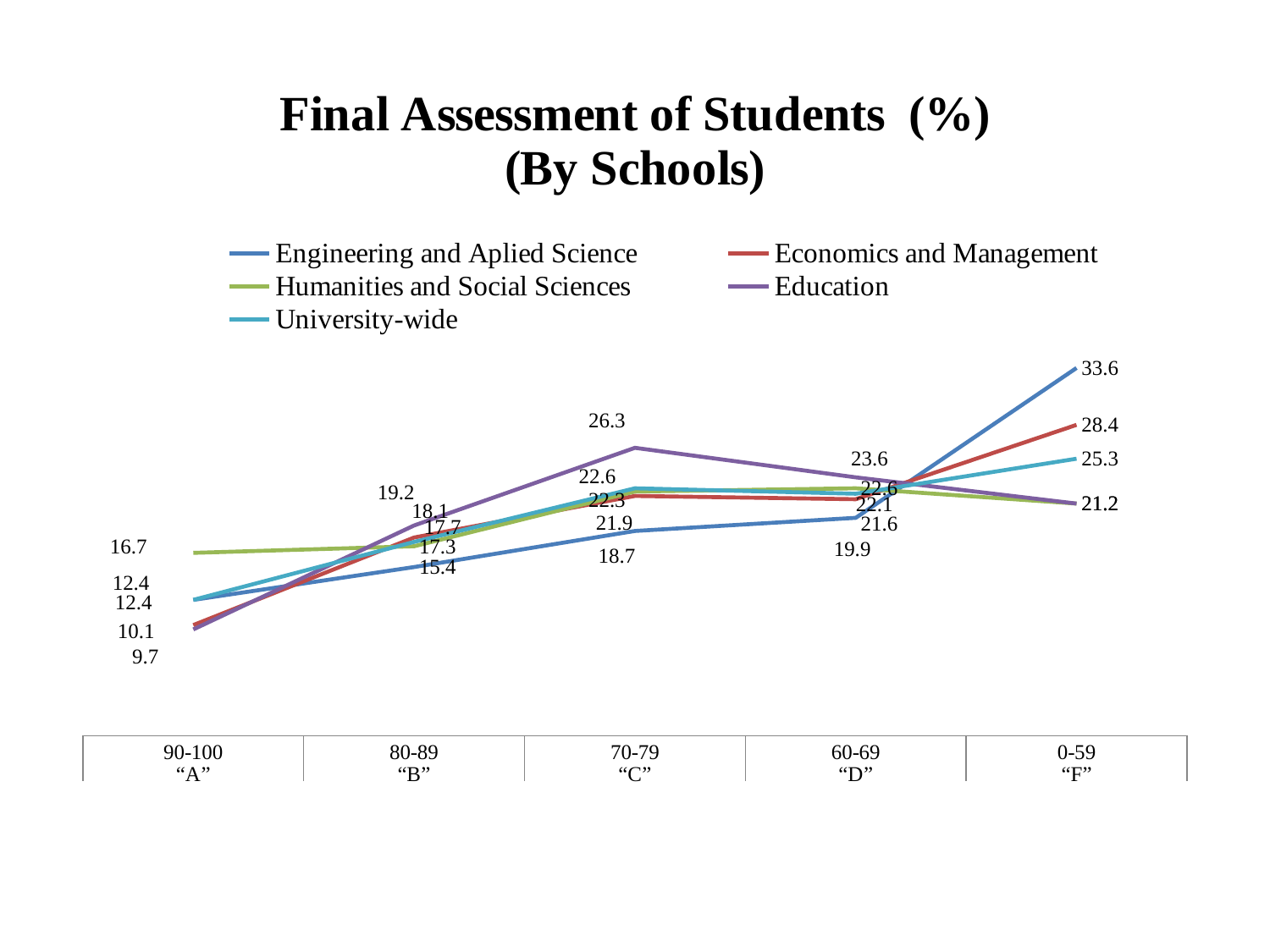
What is the value for Education in the 70-79 "C" category? 26.3 What is the value for Humanities and Social Sciences in the 90-100 "A" category? 16.7 What is the difference between Engineering and Aplied Science and Economics and Management in the 0-59 "F" category? 5.2 How many grade categories are shown on the x axis? 5 How many series does the legend list? 5 What is the value for Engineering and Aplied Science in the 80-89 "B" category? 15.4 Which school has the highest value in the 0-59 "F" category? Engineering and Aplied Science What is the value for Engineering and Aplied Science in the 0-59 "F" category? 33.6 What is the value for Economics and Management in the 0-59 "F" category? 28.4 What kind of chart is shown on the slide? line chart Does the Engineering and Aplied Science line rise or fall from 90-100 "A" to 0-59 "F"? rise What is the University-wide value in the 0-59 "F" category? 25.3